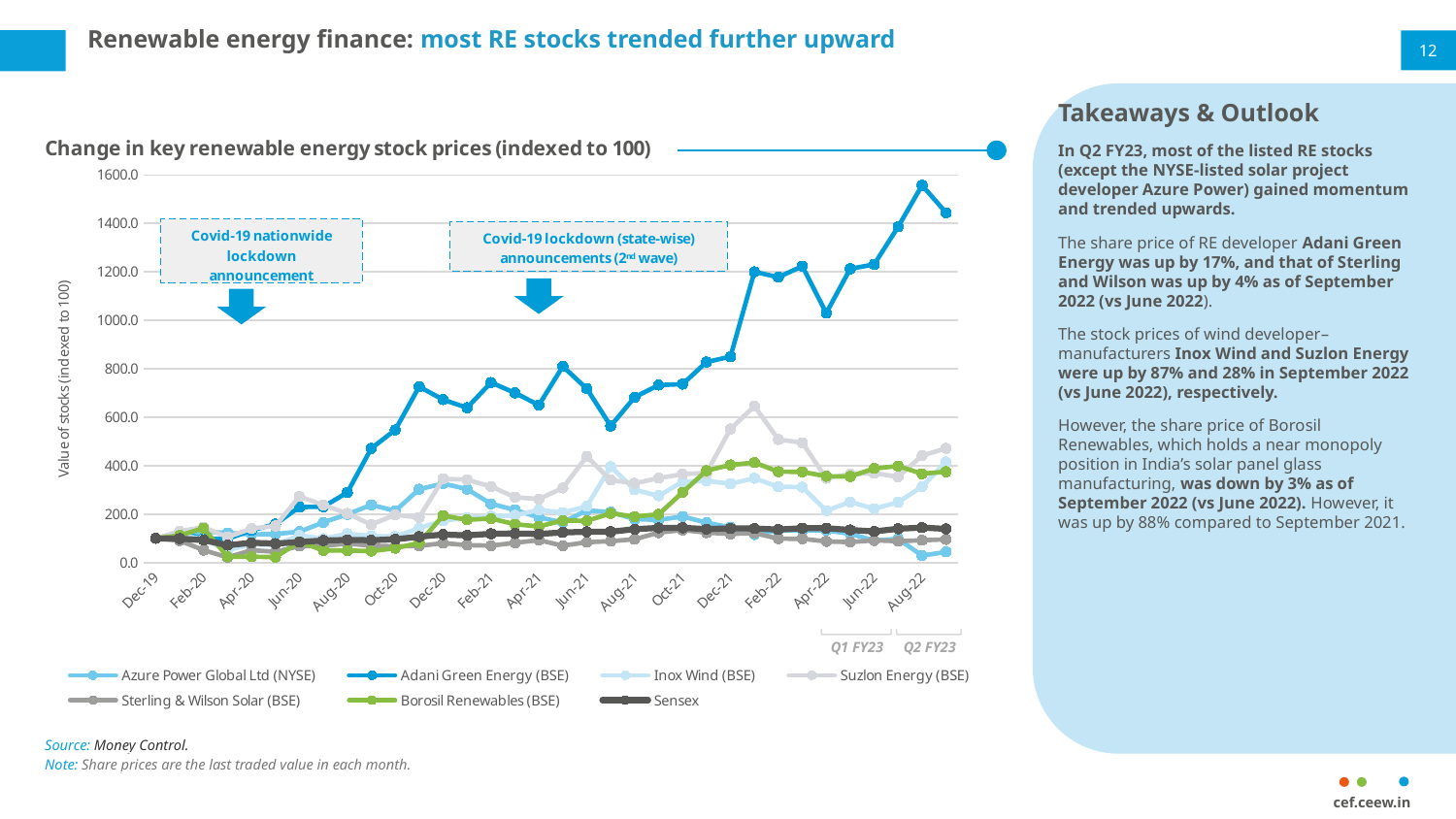
Is the peak value of Adani Green Energy (BSE) greater or less than 1400? greater What is the title of the chart? Change in key renewable energy stock prices (indexed to 100) Which series has the lowest value at Aug-22? Azure Power Global Ltd (NYSE) What type of chart is shown on the slide? line chart What is the highest value shown on the y axis? 1600.0 What is the first month label on the x axis? Dec-19 Does the Adani Green Energy (BSE) line rise or fall overall from Dec-19 to Aug-22? rise Which series has the highest value at Aug-22? Adani Green Energy (BSE) Is the value for Adani Green Energy (BSE) at Dec-21 greater or less than 1000? less Is the value for Azure Power Global Ltd (NYSE) at Aug-22 greater or less than 200? less How many series does the chart legend list? 7 At Aug-22, which is larger: Adani Green Energy (BSE) or Borosil Renewables (BSE)? Adani Green Energy (BSE)